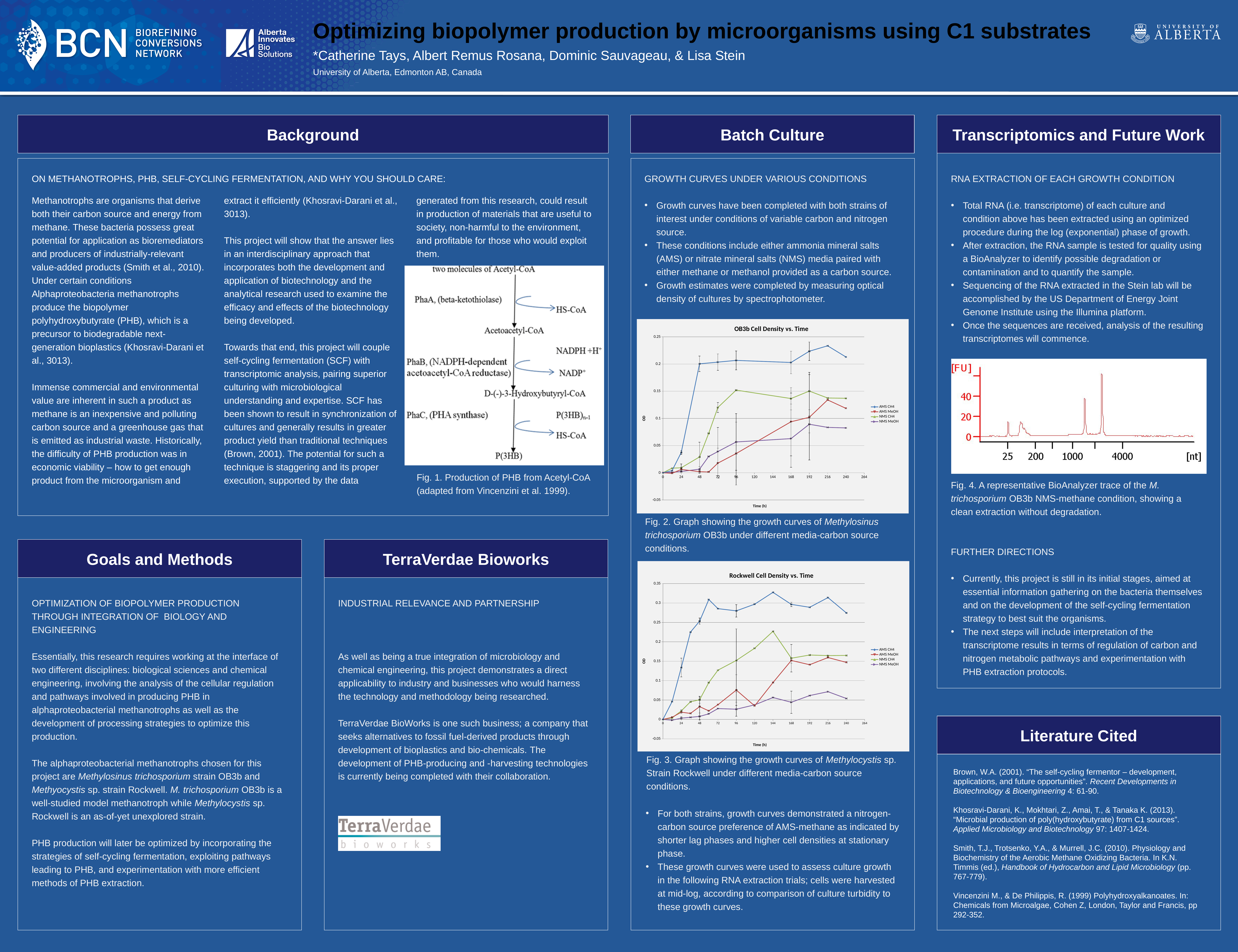
In the "Rockwell Cell Density vs. Time" chart, is the AMS CH4 value at 144 h greater or less than 0.3? greater In the "OB3b Cell Density vs. Time" chart, which series reaches the highest OD? AMS CH4 How many series does the legend of the "OB3b Cell Density vs. Time" chart list? 4 What are the legend entries of the "Rockwell Cell Density vs. Time" chart? AMS CH4, AMS MeOH, NMS CH4, NMS MeOH What kind of chart is the "OB3b Cell Density vs. Time" chart? Line chart What kind of chart is the "Rockwell Cell Density vs. Time" chart? Line chart What is the x-axis label of the "Rockwell Cell Density vs. Time" chart? Time (h) In the "Rockwell Cell Density vs. Time" chart, which series has the lower OD at 240 h: AMS CH4 or NMS MeOH? NMS MeOH In the "OB3b Cell Density vs. Time" chart, is the NMS MeOH value at 240 h greater or less than 0.15? less In the "OB3b Cell Density vs. Time" chart, is the AMS CH4 value at 216 h greater or less than 0.2? greater In the "OB3b Cell Density vs. Time" chart, does the AMS CH4 series rise or fall between 0 h and 48 h? Rise In the "Rockwell Cell Density vs. Time" chart, which series reaches the highest OD? AMS CH4